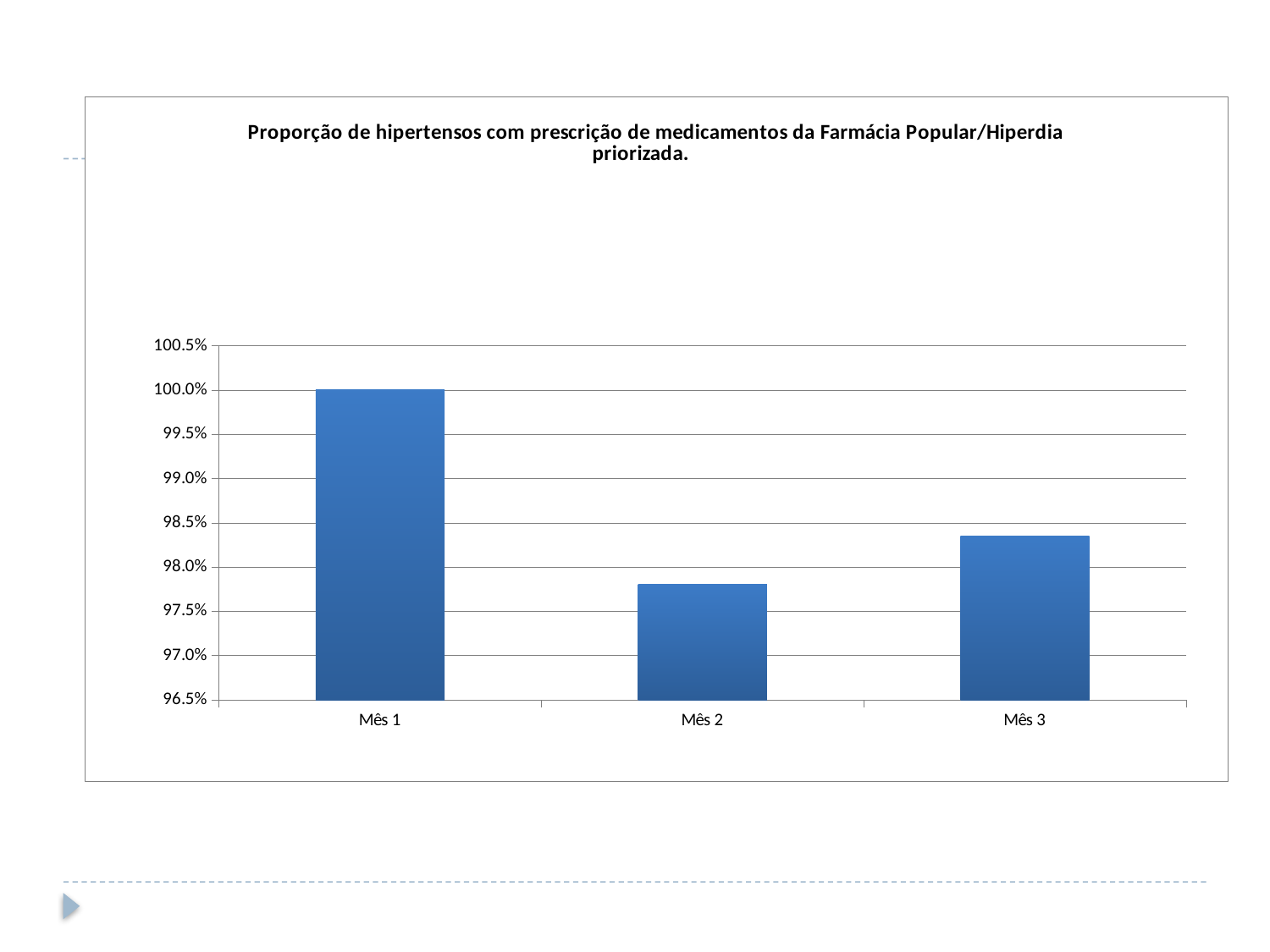
Which month has the highest value? Mês 1 How many categories (months) are shown on the x axis? 3 Which is larger, the value for Mês 2 or the value for Mês 3? Mês 3 What is the title of the chart? Proporção de hipertensos com prescrição de medicamentos da Farmácia Popular/Hiperdia priorizada. Which month has the lowest value? Mês 2 What type of chart is shown on the slide? bar chart What is the value for Mês 1? 100.0% Is the value for Mês 2 greater or less than 97.5%? greater Is the value for Mês 2 greater or less than 98.0%? less Is the value for Mês 3 greater or less than 98.0%? greater Does the value rise or fall from Mês 1 to Mês 2? fall